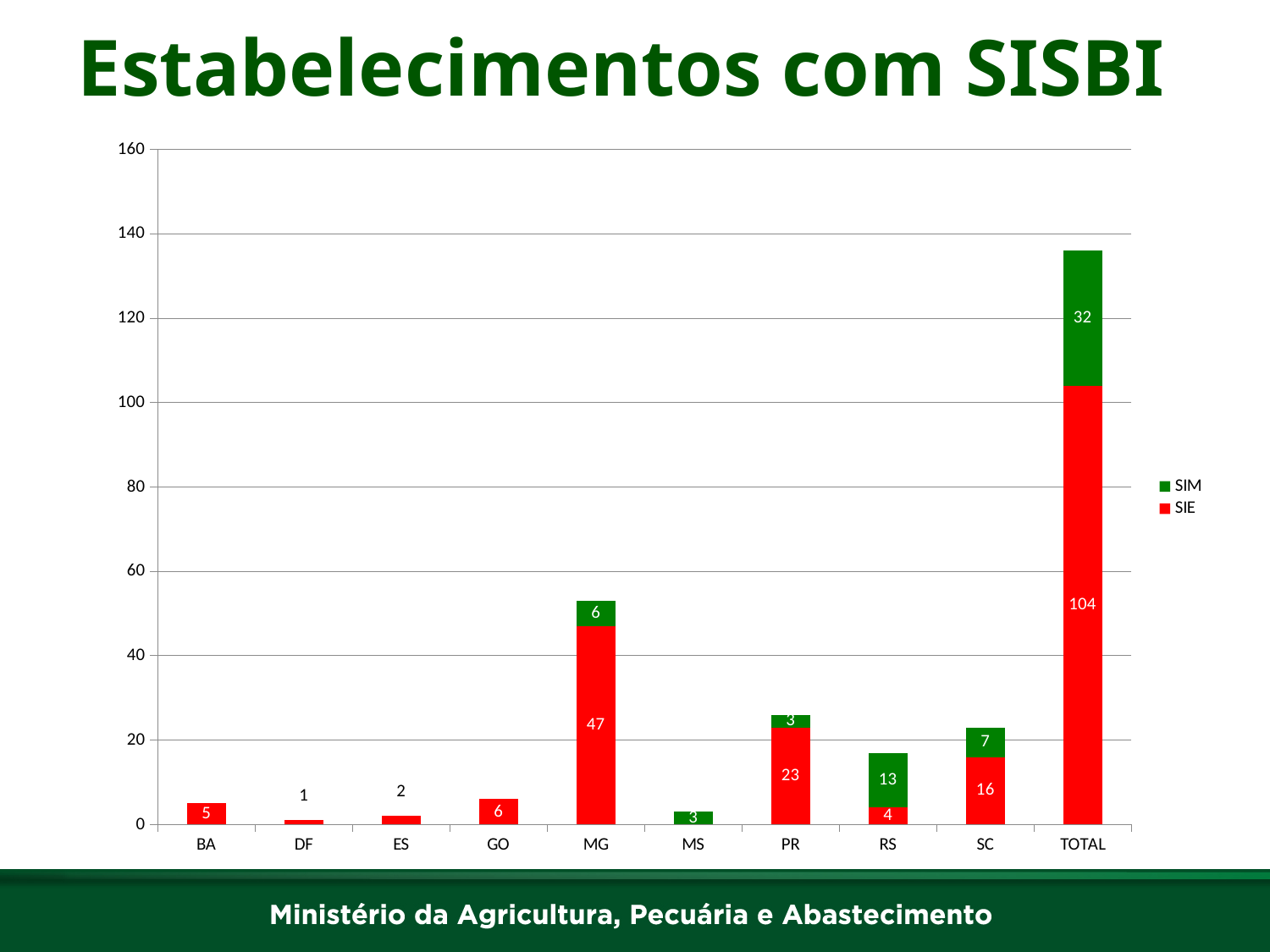
What is the SIE value for TOTAL? 104 What is the total of the stacked bar for PR? 26 What kind of chart is shown on the slide? Stacked bar chart Which is larger, the SIE value for SC or the SIE value for GO? SC What is the SIM value for RS? 13 What is the total of the stacked bar for TOTAL? 136 What is the difference between the SIE values for MG and PR? 24 Excluding TOTAL, which state has the lowest SIE value? DF How many series does the legend list? 2 What is the SIM value for SC? 7 Excluding TOTAL, which state has the highest SIE value? MG What is the SIE value for MG? 47